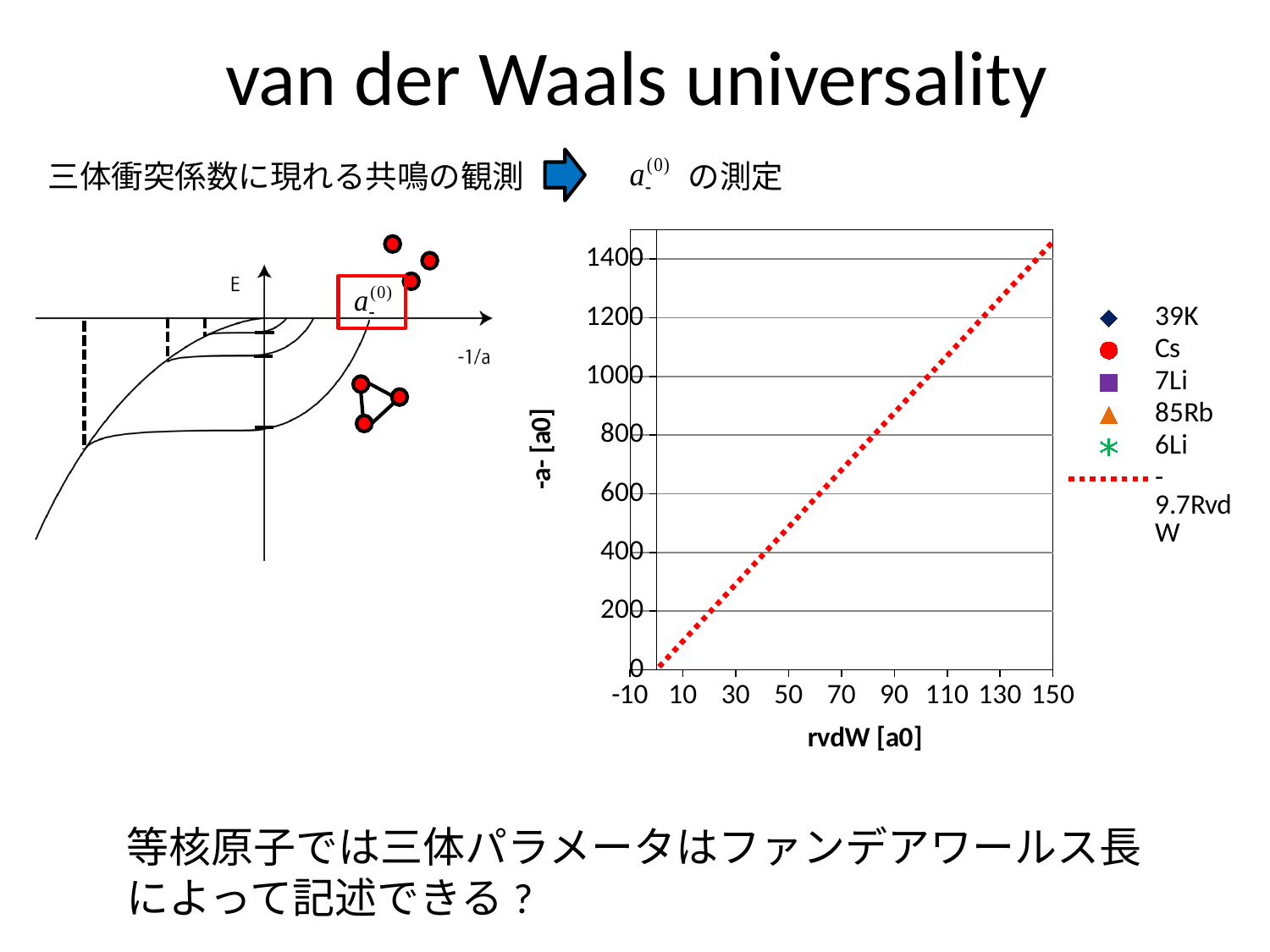
Is the value of the dotted -9.7RvdW line at rvdW = 100 greater or less than 800? greater What kind of chart is shown on the right of the slide? scatter chart with a dotted line Does the dotted red line rise or fall as rvdW increases along the x axis? rises What is the label of the horizontal axis of the chart? rvdW [a0] What is the label of the vertical axis of the chart? -a- [a0] How many tick labels are shown on the horizontal axis of the chart? 9 What is the highest tick value shown on the vertical axis of the chart? 1400 Is the value of the dotted -9.7RvdW line at rvdW = 30 greater or less than 200? greater How many entries does the legend of the chart list? 6 Is the value of the dotted -9.7RvdW line at rvdW = 50 greater or less than 600? less